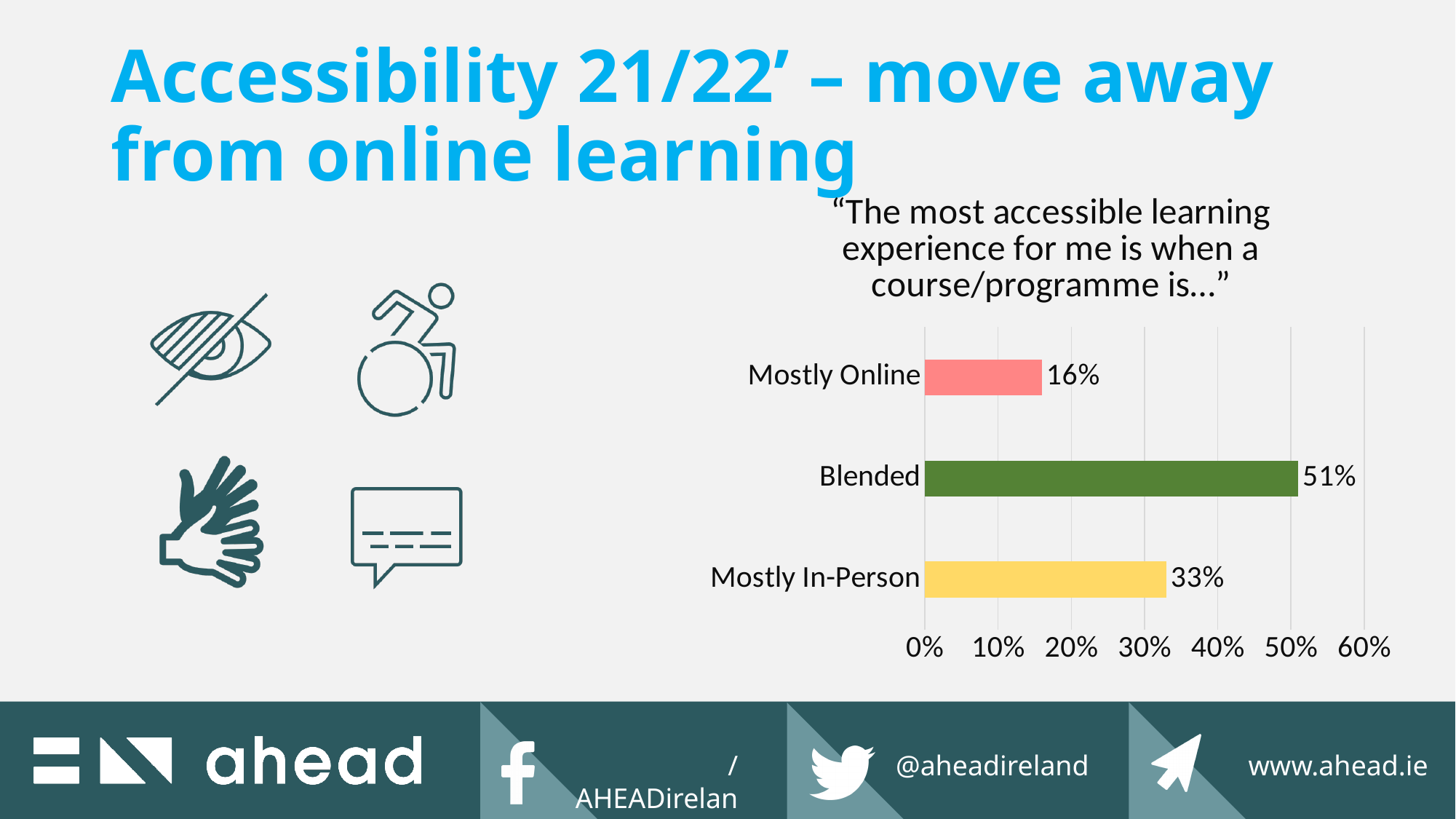
What value is shown for Mostly In-Person in the chart? 33% Which category has the highest value in the chart? Blended What is the difference between the values for Mostly In-Person and Mostly Online? 17% Which is larger, the value for Mostly In-Person or the value for Mostly Online? Mostly In-Person What value is shown for Blended in the chart? 51% How many categories are shown in the chart? 3 What kind of chart is shown on the slide? Bar chart Which category has the lowest value in the chart? Mostly Online What percentage of respondents said the most accessible learning experience is when a course/programme is Mostly Online? 16% What is the title of the chart? "The most accessible learning experience for me is when a course/programme is..." Is the value for Blended greater or less than 40%? greater What is the difference between the values for Blended and Mostly In-Person? 18%